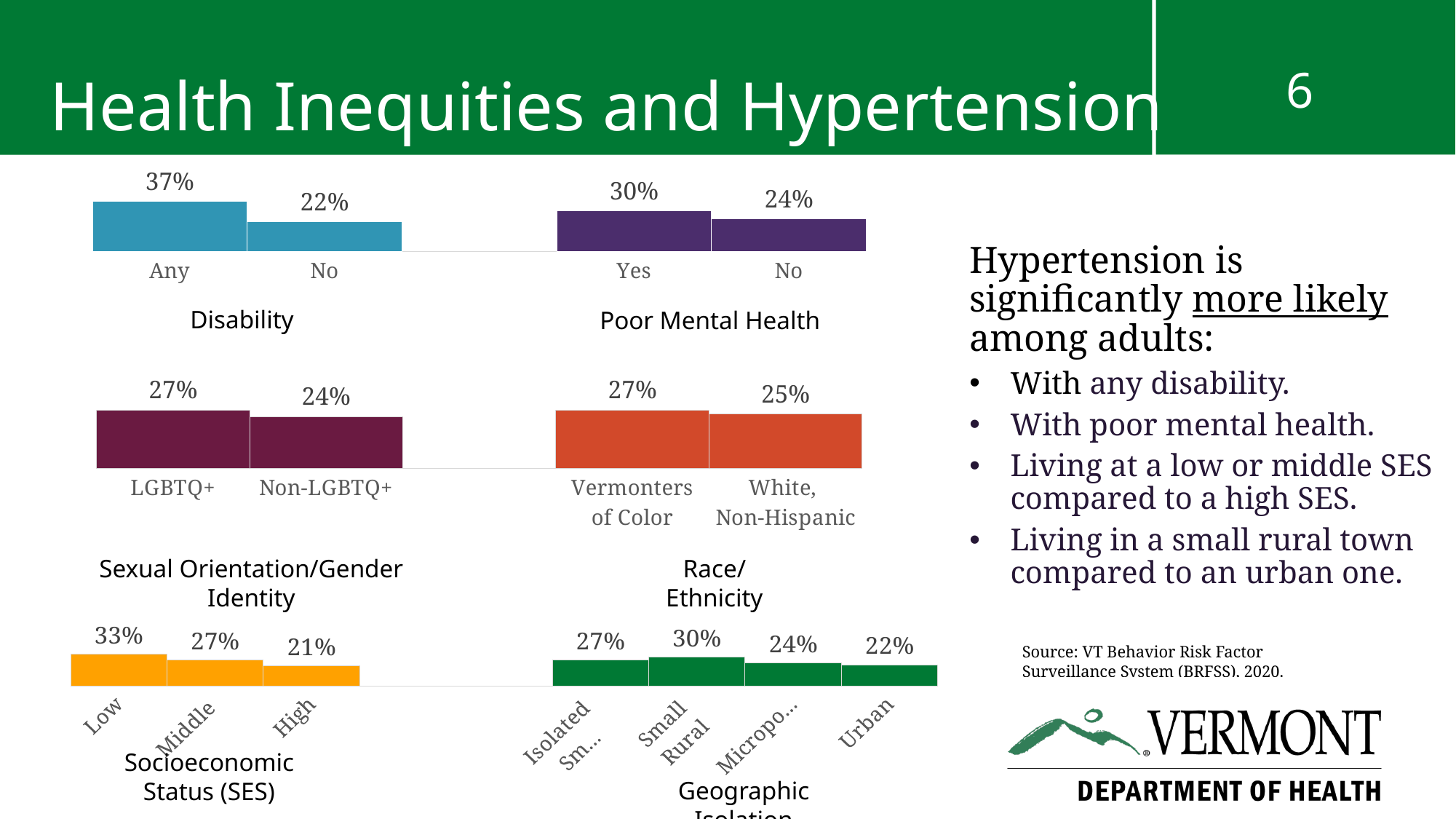
In the Socioeconomic Status (SES) chart, do the values rise or fall from Low to High? fall In the Race/Ethnicity chart, what is the value for White, Non-Hispanic? 25% In the bottom-right Geographic chart, what is the value for Urban? 22% In the Poor Mental Health chart, what is the value for 'Yes'? 30% In the Socioeconomic Status (SES) chart, which category has the lowest value? High In the Disability chart, what is the difference between the 'Any' and 'No' values? 15% What type of chart is the Poor Mental Health chart? bar chart In the Disability chart, what is the value for adults with any disability? 37% In the bottom-right Geographic chart, which category has the highest value? Small Rural In the Socioeconomic Status (SES) chart, what is the value for Low? 33% In the Sexual Orientation/Gender Identity chart, which category has the higher value, LGBTQ+ or Non-LGBTQ+? LGBTQ+ How many categories are shown in the bottom-right Geographic chart? 4